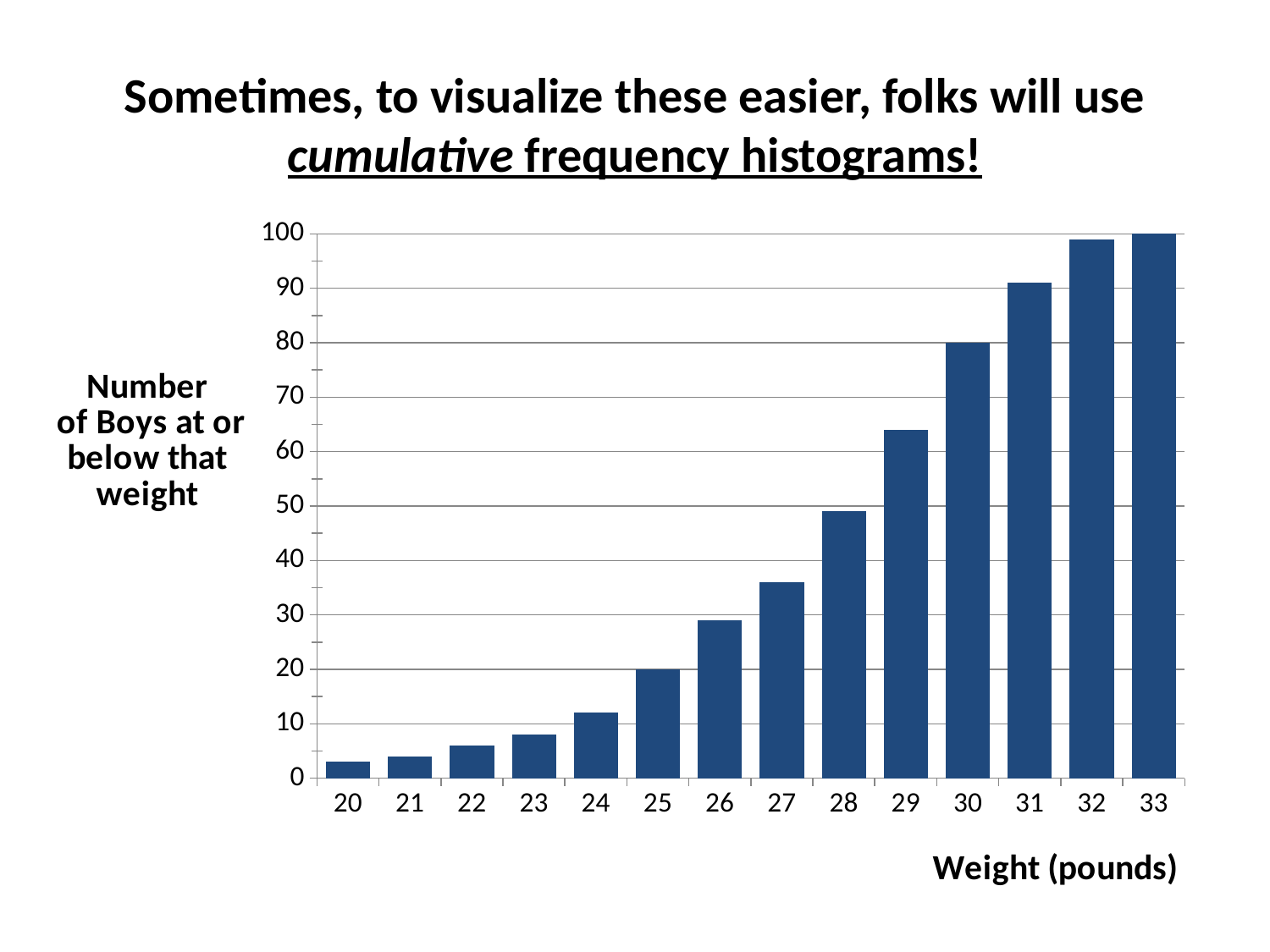
Is the value for 29 pounds greater or less than 60? greater Is the value for 27 pounds greater or less than 30? greater Which weight has the lowest number of boys at or below that weight? 20 What is the label of the x axis? Weight (pounds) Do the values rise or fall as weight increases along the x axis? rise What type of chart is shown on the slide? bar chart Is the value for 22 pounds greater or less than 10? less How many weight categories are shown on the x axis? 14 What is the number of boys at or below 30 pounds? 80 What is the number of boys at or below 33 pounds? 100 Which weight has the highest number of boys at or below that weight? 33 What is the number of boys at or below 25 pounds? 20